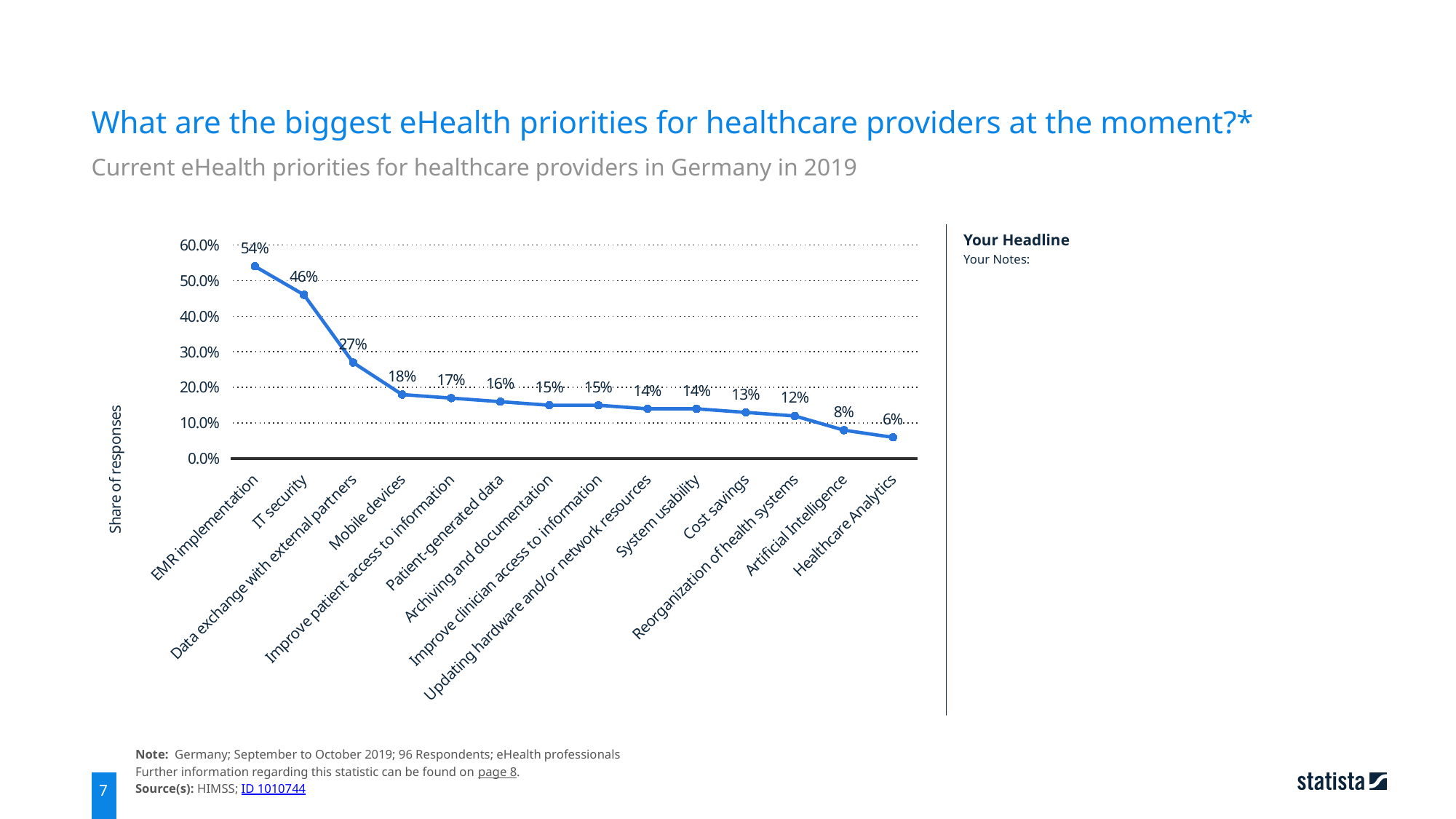
Is the value for Cost savings greater or less than 20.0%? less What is the difference in share of responses between EMR implementation and IT security? 8% What is the share of responses for Mobile devices? 18% Do the values rise or fall from left to right along the x axis? Fall What kind of chart is shown on the slide? Line chart Which category has the highest share of responses? EMR implementation What is the share of responses for EMR implementation? 54% What is the share of responses for IT security? 46% What is the share of responses for Artificial Intelligence? 8% Which category has the lowest share of responses? Healthcare Analytics How many categories are plotted on the chart? 14 Which has a larger share of responses, Data exchange with external partners or Mobile devices? Data exchange with external partners